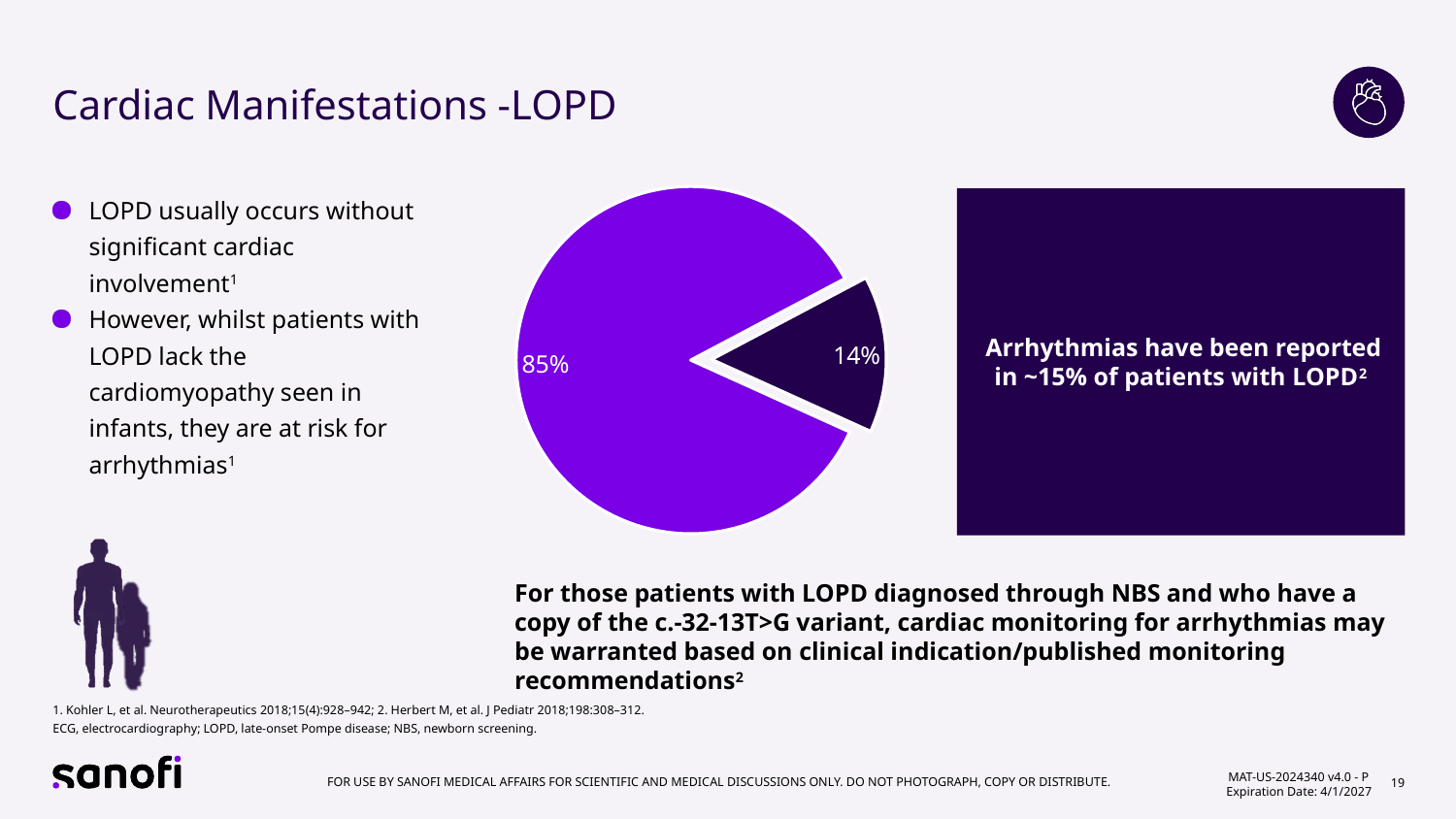
What value is printed on the dark-coloured slice of the pie chart? 14% What kind of chart is shown on the slide? Pie chart Does the pie chart have a legend? No What is the difference between the two values shown on the pie chart? 71 percentage points What value is printed on the smallest slice of the pie chart? 14% Is the value of the smaller slice of the pie chart greater or less than 50%? less What value is printed on the bright purple slice of the pie chart? 85% What share of the pie does the slice pulled out from the rest of the pie represent? 14% Which slice of the pie chart is exploded (separated from the rest of the pie)? The 14% slice Which slice of the pie chart is larger, the one labelled 85% or the one labelled 14%? 85% How many slices does the pie chart have? 2 What value is printed on the largest slice of the pie chart? 85%